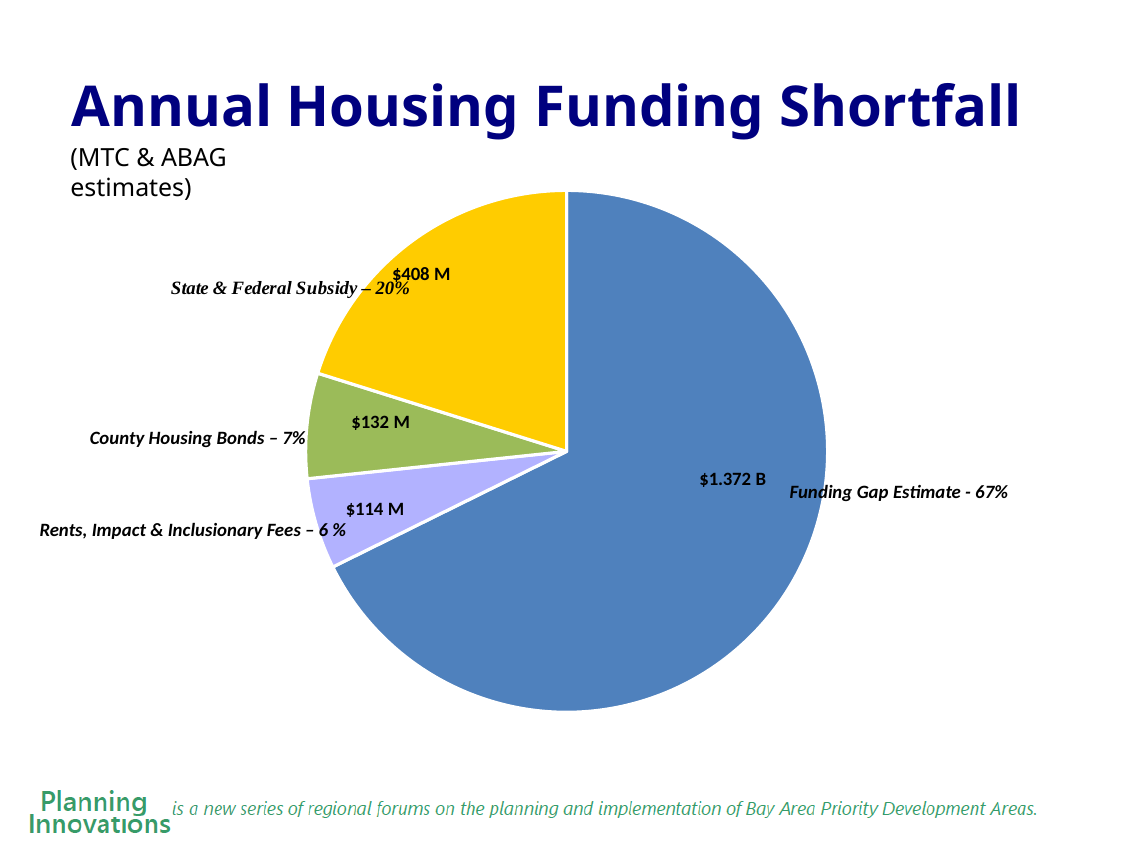
What is the difference between the State & Federal Subsidy value and the County Housing Bonds value? $276 M What share of the pie does State & Federal Subsidy represent? 20% How many slices does the pie chart have? 4 What is the value shown for the Funding Gap Estimate slice? $1.372 B Which slice of the pie is the largest? Funding Gap Estimate What kind of chart is shown on the slide? Pie chart What is the value shown for State & Federal Subsidy? $408 M What is the value shown for Rents, Impact & Inclusionary Fees? $114 M What is the value shown for County Housing Bonds? $132 M Which slice of the pie is the smallest? Rents, Impact & Inclusionary Fees Which is larger, County Housing Bonds or Rents, Impact & Inclusionary Fees? County Housing Bonds What share of the pie does the Funding Gap Estimate represent? 67%